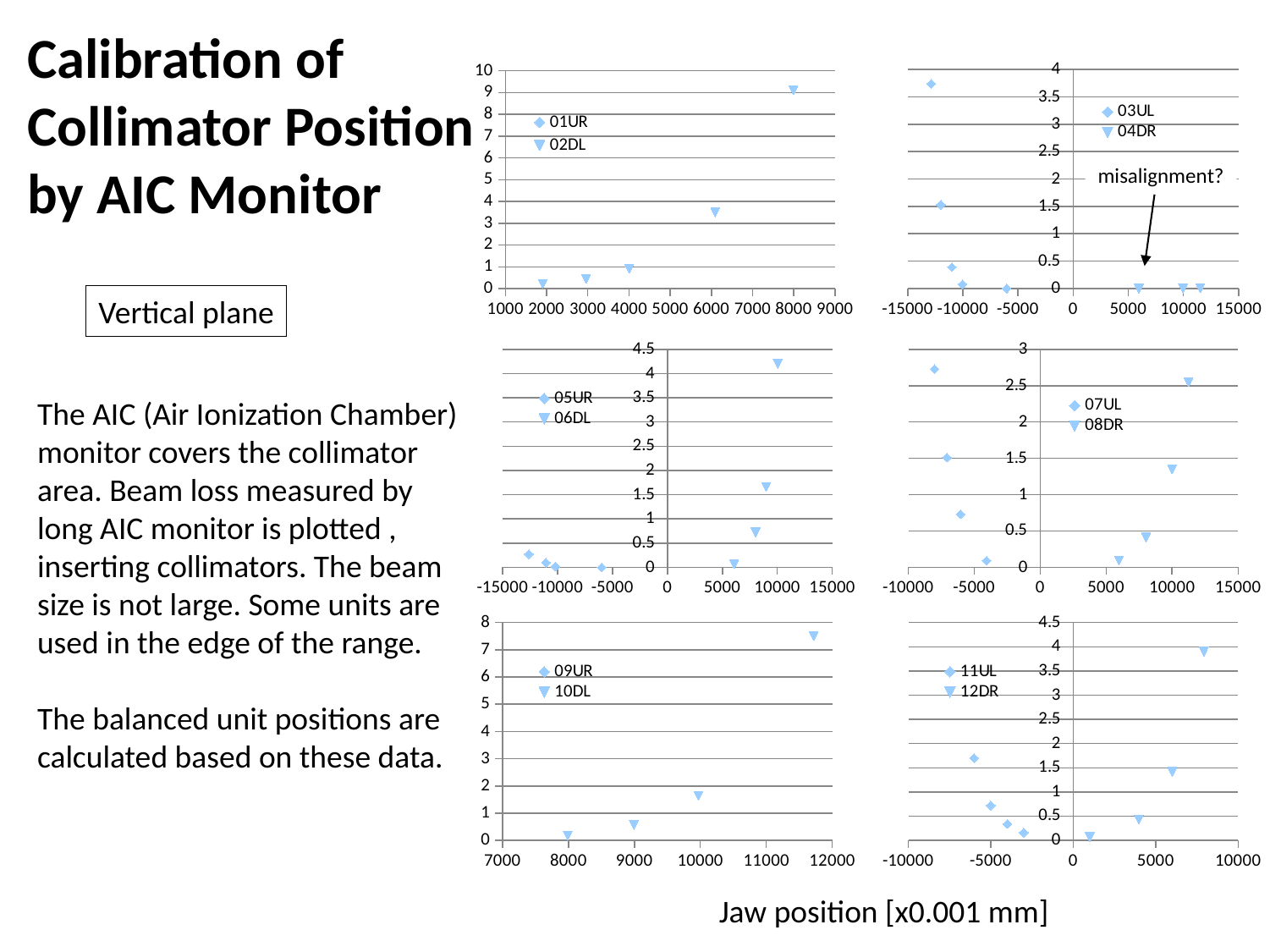
In the top-left chart, do the 02DL values rise or fall as the jaw position increases? rise In the top-right chart, is the 03UL value at the leftmost point (around -12500) greater or less than 3? greater What kind of chart is the top-left chart with the 01UR and 02DL legend? scatter chart In the top-right chart, do the 03UL values rise or fall as the jaw position increases from -15000 toward 0? fall How many series does the legend of the top-right chart list? 2 What is the x-axis label given below the charts? Jaw position [x0.001 mm] In the bottom-right chart, is the 12DR value at jaw position 8000 greater or less than 3? greater In the bottom-left chart, is the 10DL value at the rightmost point (near 11700) greater or less than 5? greater What are the two legend entries of the middle-right chart? 07UL and 08DR How many charts are shown on the slide? 6